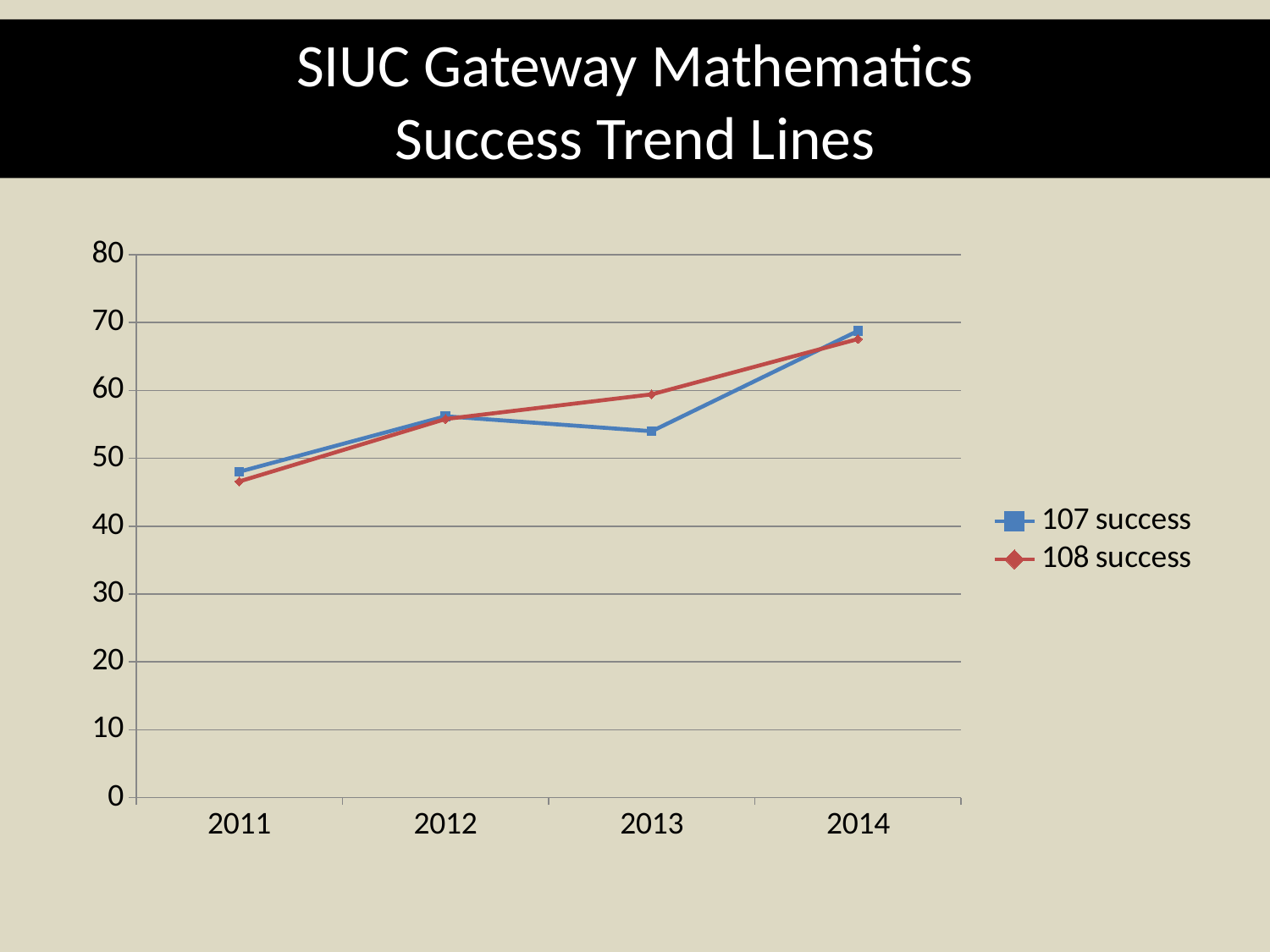
How many years are shown on the x axis? 4 How many series does the legend list? 2 Is the value for 108 success in 2013 greater or less than 50? greater Is the value for 107 success in 2013 greater or less than 60? less Is the value for 107 success in 2011 greater or less than 50? less In 2013, which series has the higher value, 107 success or 108 success? 108 success What is the title of the slide? SIUC Gateway Mathematics Success Trend Lines In which year is 108 success highest? 2014 Does the 108 success line rise or fall from 2011 to 2014? rise In which year is 107 success lowest? 2011 What kind of chart is shown on the slide? line chart